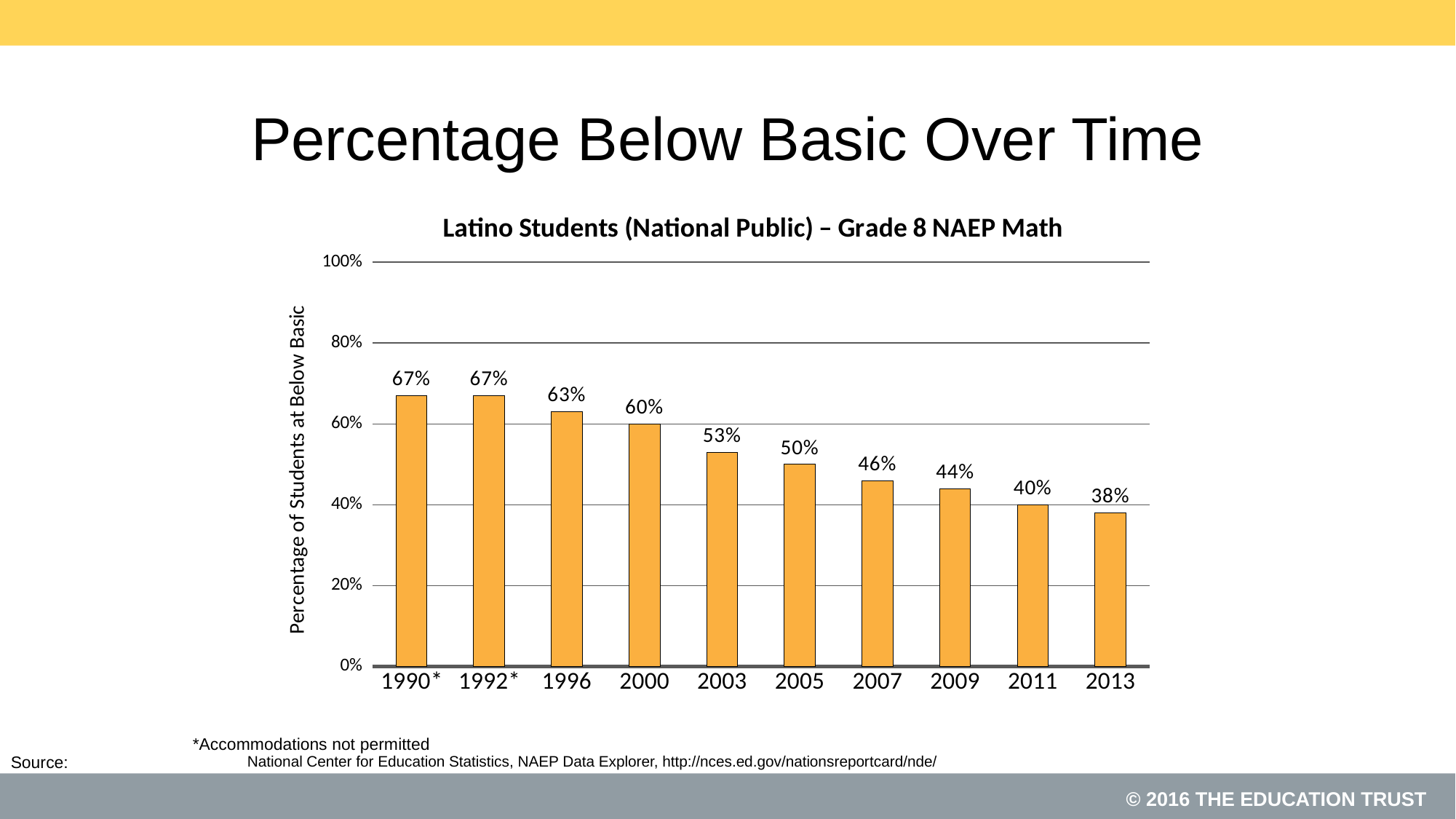
What is the percentage of Latino students at Below Basic in 2003? 53% How many years are shown on the x axis? 10 Which is larger, the value for 2007 or the value for 2011? 2007 What kind of chart is shown on the slide? Bar chart Which year has the lowest percentage of students at Below Basic? 2013 Is the value for 2009 greater or less than 60%? less What is the difference between the 1990* value and the 2013 value? 29 percentage points What is the title of the chart? Latino Students (National Public) – Grade 8 NAEP Math What is the percentage of Latino students at Below Basic in 2013? 38% Do the values rise or fall from 1990* to 2013? Fall What is the value shown for 1996? 63% What is the difference between the values for 2000 and 2005? 10 percentage points